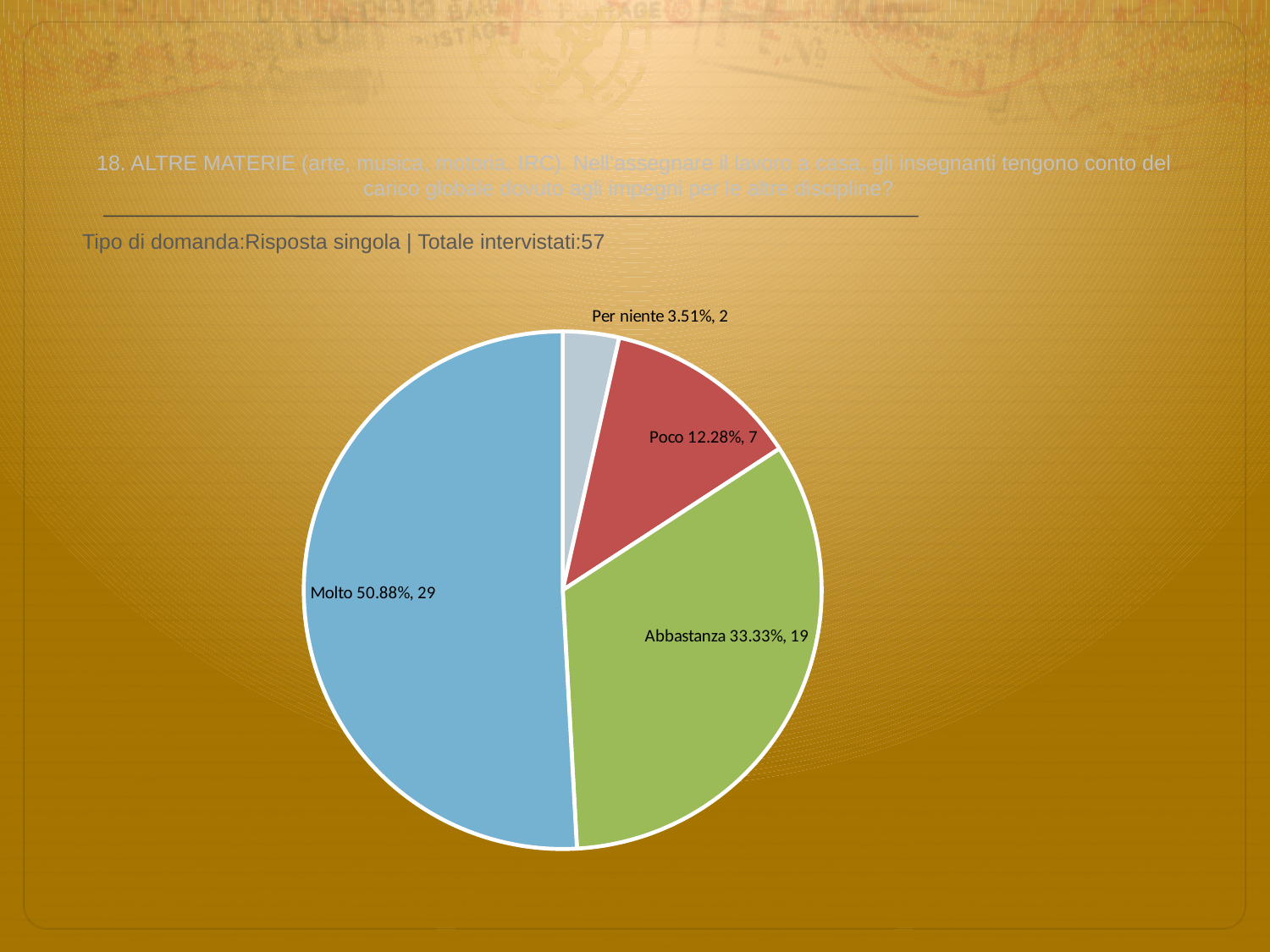
Which category has the smallest slice? Per niente What is the total number of respondents (Totale intervistati) stated on the slide? 57 What kind of chart is shown on the slide? pie chart What colour is the 'Molto' slice? blue What percentage share does the 'Molto' slice have? 50.88% How many slices does the pie chart have? 4 What percentage share does the 'Poco' slice have? 12.28% What is the count shown for 'Per niente'? 2 Which is larger, the 'Poco' slice or the 'Abbastanza' slice? Abbastanza Which category has the largest slice? Molto What is the difference in count between 'Molto' and 'Abbastanza'? 10 What is the count shown for 'Abbastanza'? 19